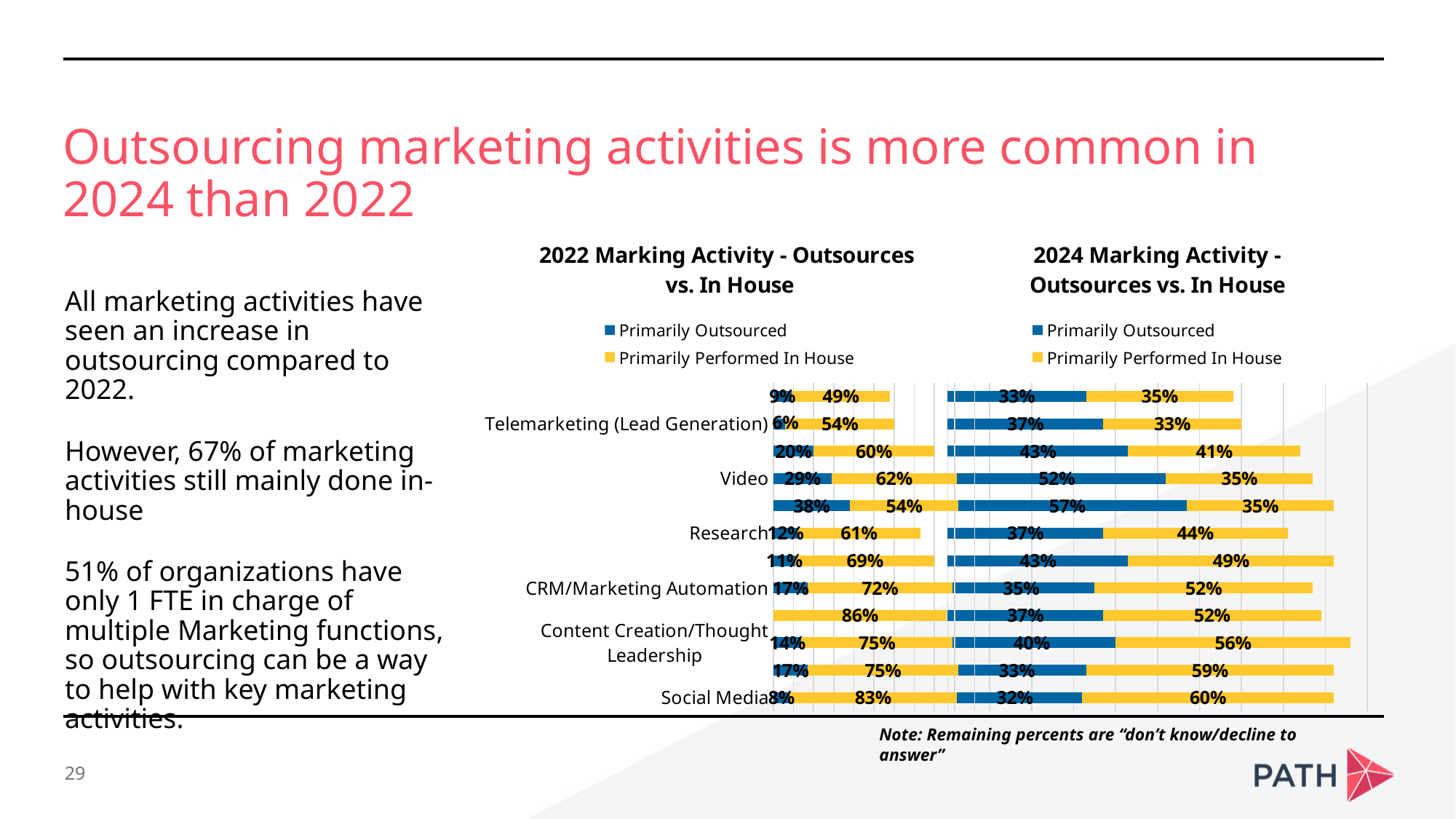
In the 2022 Marking Activity chart, what percentage of Social Media is Primarily Performed In House? 83% In the 2022 Marking Activity chart, what percentage of Telemarketing (Lead Generation) is Primarily Outsourced? 6% What are the two legend entries in the 2022 Marking Activity chart? Primarily Outsourced and Primarily Performed In House In the 2024 Marking Activity chart, for Video, which is larger: Primarily Outsourced or Primarily Performed In House? Primarily Outsourced In the 2024 Marking Activity chart, what percentage of Social Media is Primarily Outsourced? 32% In the 2024 Marking Activity chart, what is the difference between the Primarily Performed In House and Primarily Outsourced values for Social Media? 28 percentage points How many series does the legend of the 2024 Marking Activity chart list? 2 What kind of chart is the 2022 Marking Activity - Outsources vs. In House chart? Stacked bar chart In the 2024 Marking Activity chart, what percentage of Video is Primarily Outsourced? 52% In the 2024 Marking Activity chart, what percentage of Research is Primarily Performed In House? 44% In the 2022 Marking Activity chart, what percentage of CRM/Marketing Automation is Primarily Performed In House? 72% In the 2022 Marking Activity chart, what is the combined total of the Primarily Outsourced and Primarily Performed In House values for Social Media? 91%